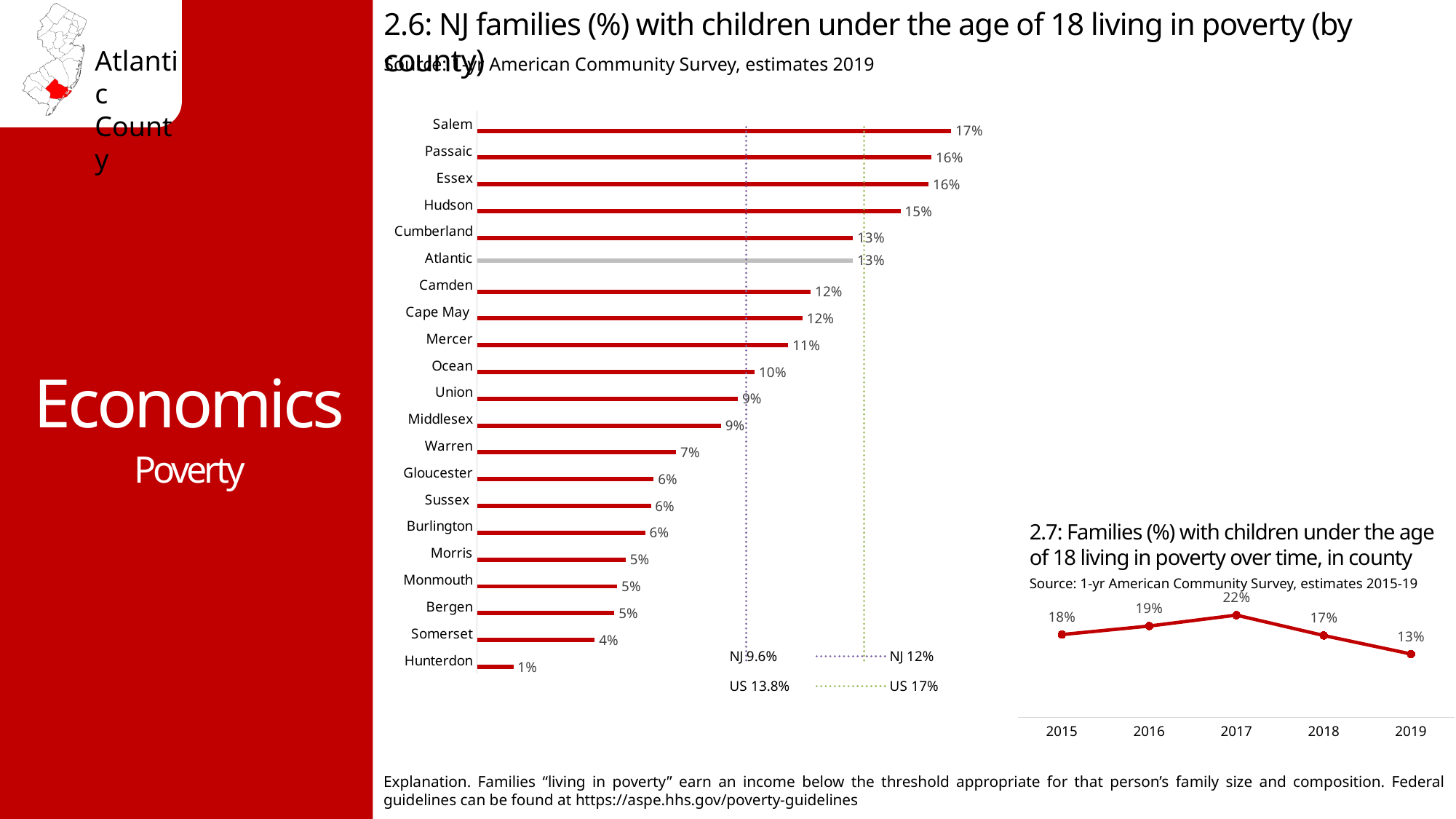
In chart 2.6, how many counties are plotted? 21 In chart 2.6, what is the value for Hudson? 15% In chart 2.6, what is the value for Atlantic? 13% In chart 2.7, do the values rise or fall from 2017 to 2019? Fall What kind of chart is chart 2.6? Bar chart In chart 2.7, what is the difference between the values for 2017 and 2019? 9% In chart 2.6, what is the difference between the values for Salem and Hunterdon? 16% In chart 2.6, which county has the lowest value? Hunterdon In chart 2.7, which year has the lowest value? 2019 In chart 2.7, what is the value for 2017? 22% In chart 2.6, which county has the highest value? Salem In chart 2.6, which is larger, the value for Camden or the value for Warren? Camden